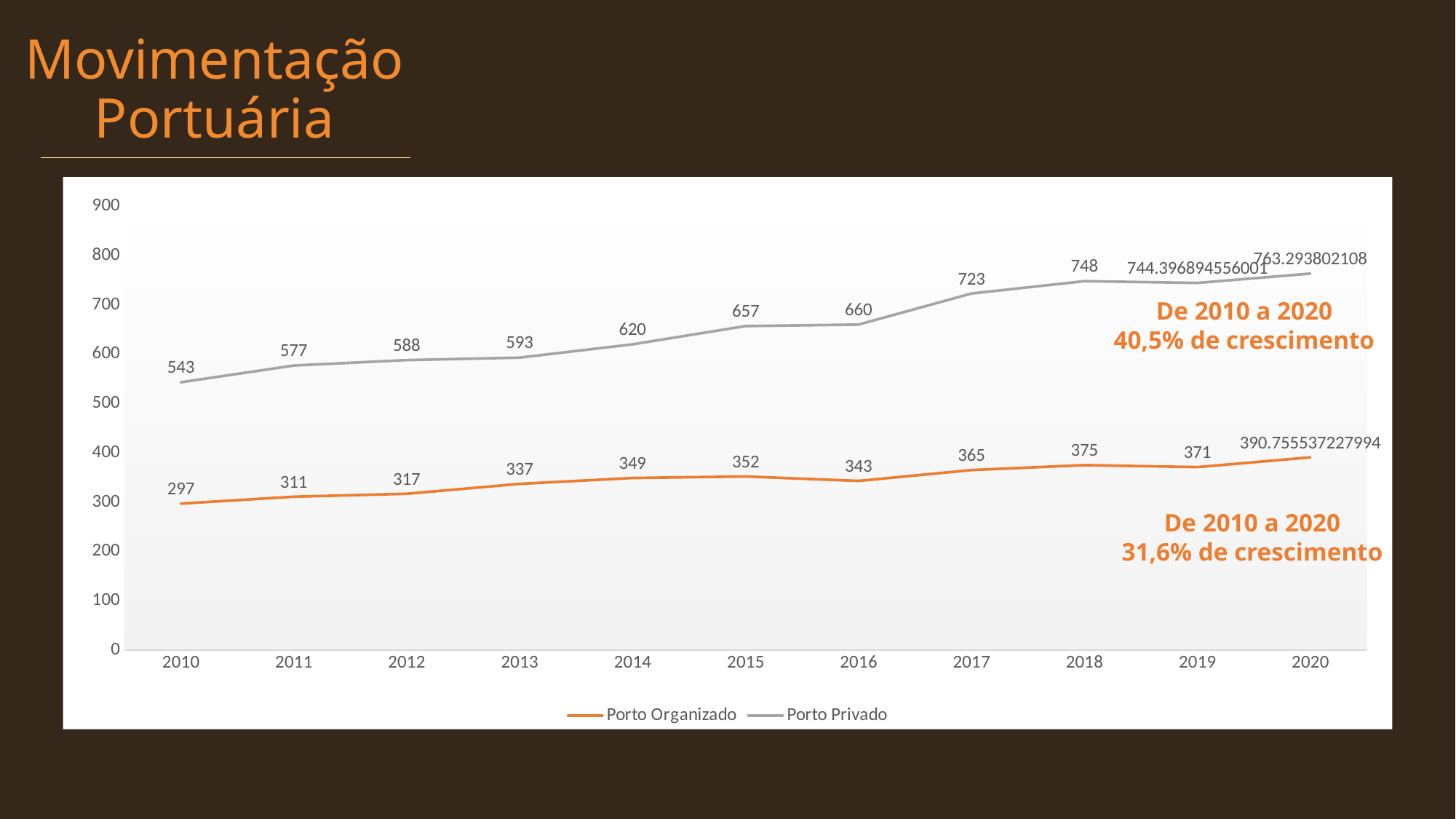
In which year is the Porto Privado value highest? 2020 What is the value for Porto Privado in 2010? 543 Which is larger, the Porto Organizado value in 2015 or in 2016? 2015 Does the Porto Privado series generally rise or fall from 2010 to 2020? rise Which series is drawn in orange? Porto Organizado What kind of chart is shown on the slide? line chart What is the difference between the Porto Privado and Porto Organizado values in 2018? 373 In which year is the Porto Organizado value lowest? 2010 How many series does the legend list? 2 How many years are shown on the x axis? 11 What is the value for Porto Organizado in 2016? 343 What is the value for Porto Privado in 2017? 723